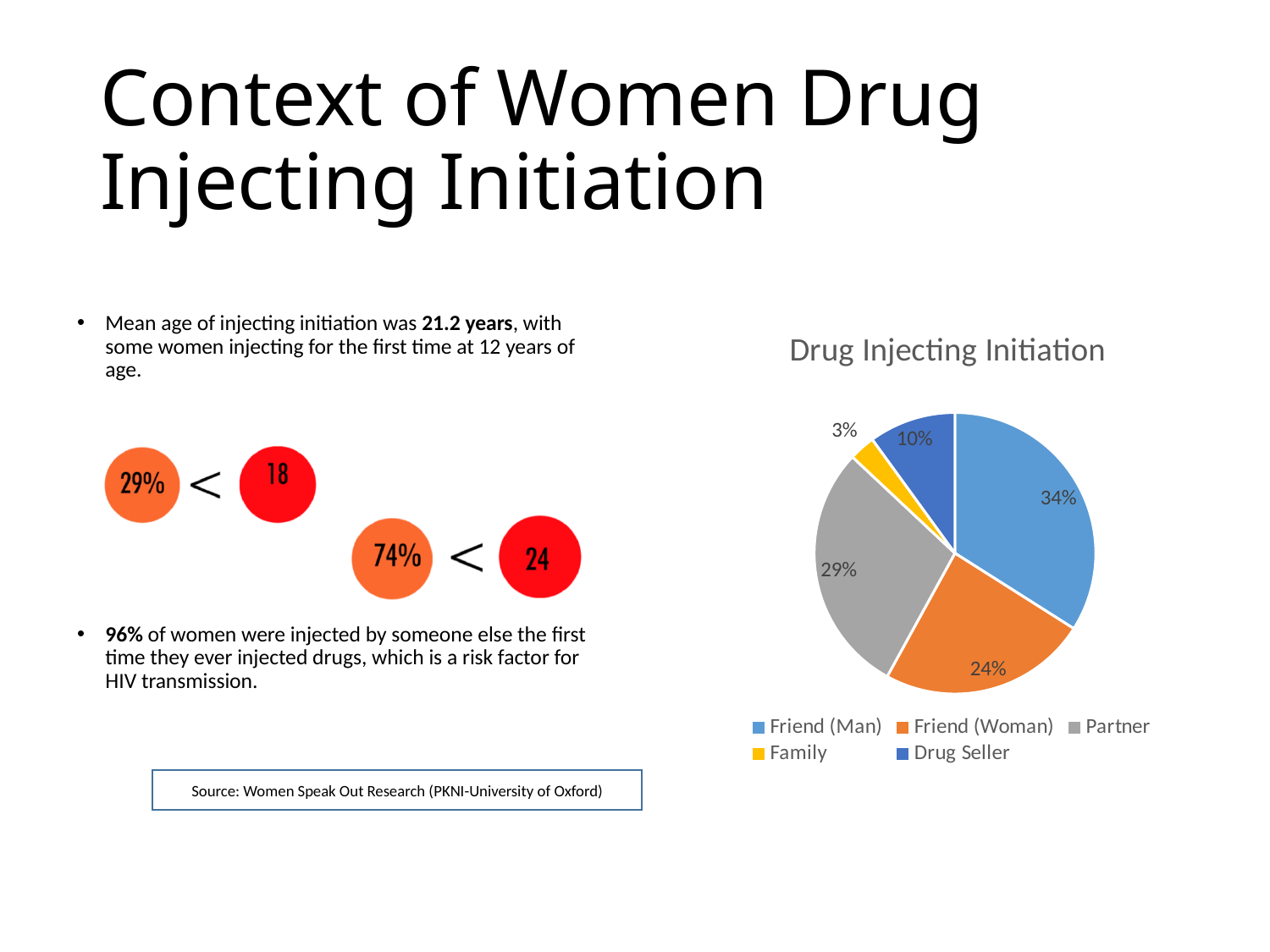
What is the title of the chart? Drug Injecting Initiation How many categories does the pie chart show? 5 What type of chart is shown on the slide? pie chart What share of the pie is Partner? 29% What share of the pie is Friend (Woman)? 24% What share of the pie is Friend (Man)? 34% Which is larger, the Partner slice or the Drug Seller slice? Partner Which category has the largest slice of the pie? Friend (Man) Which category has the smallest slice of the pie? Family What is the difference in percentage points between Friend (Man) and Friend (Woman)? 10